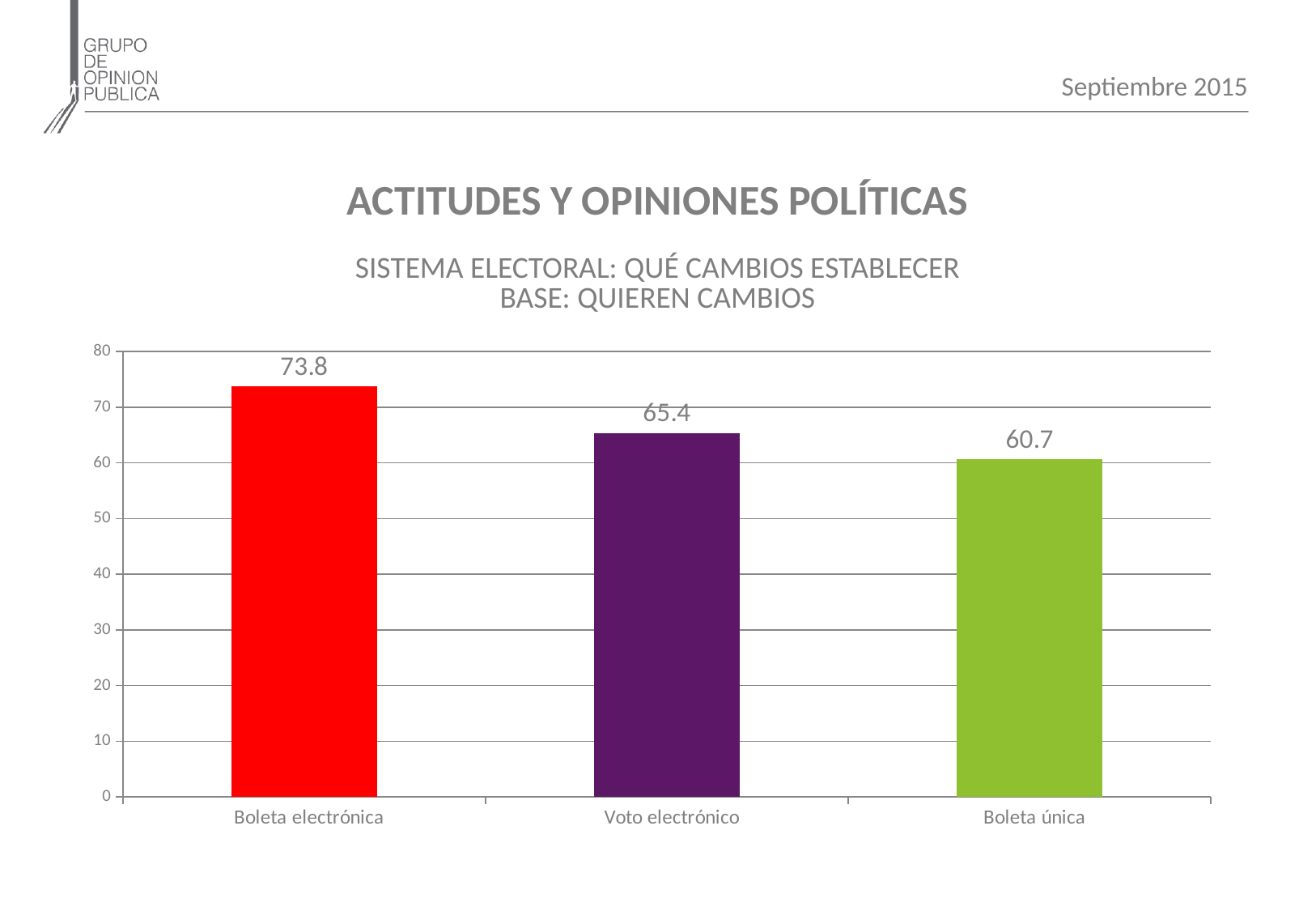
What kind of chart is shown on the slide? bar chart Is the value for Voto electrónico greater or less than 70? less What is the difference between the values for Boleta electrónica and Boleta única? 13.1 Which is larger, the value for Voto electrónico or the value for Boleta única? Voto electrónico Which category has the lowest value? Boleta única Which category has the highest value? Boleta electrónica What colour is the bar for Boleta única? green What is the difference between the values for Voto electrónico and Boleta única? 4.7 What is the value for Boleta única? 60.7 What is the value for Boleta electrónica? 73.8 How many categories are shown in the chart? 3 What is the value for Voto electrónico? 65.4